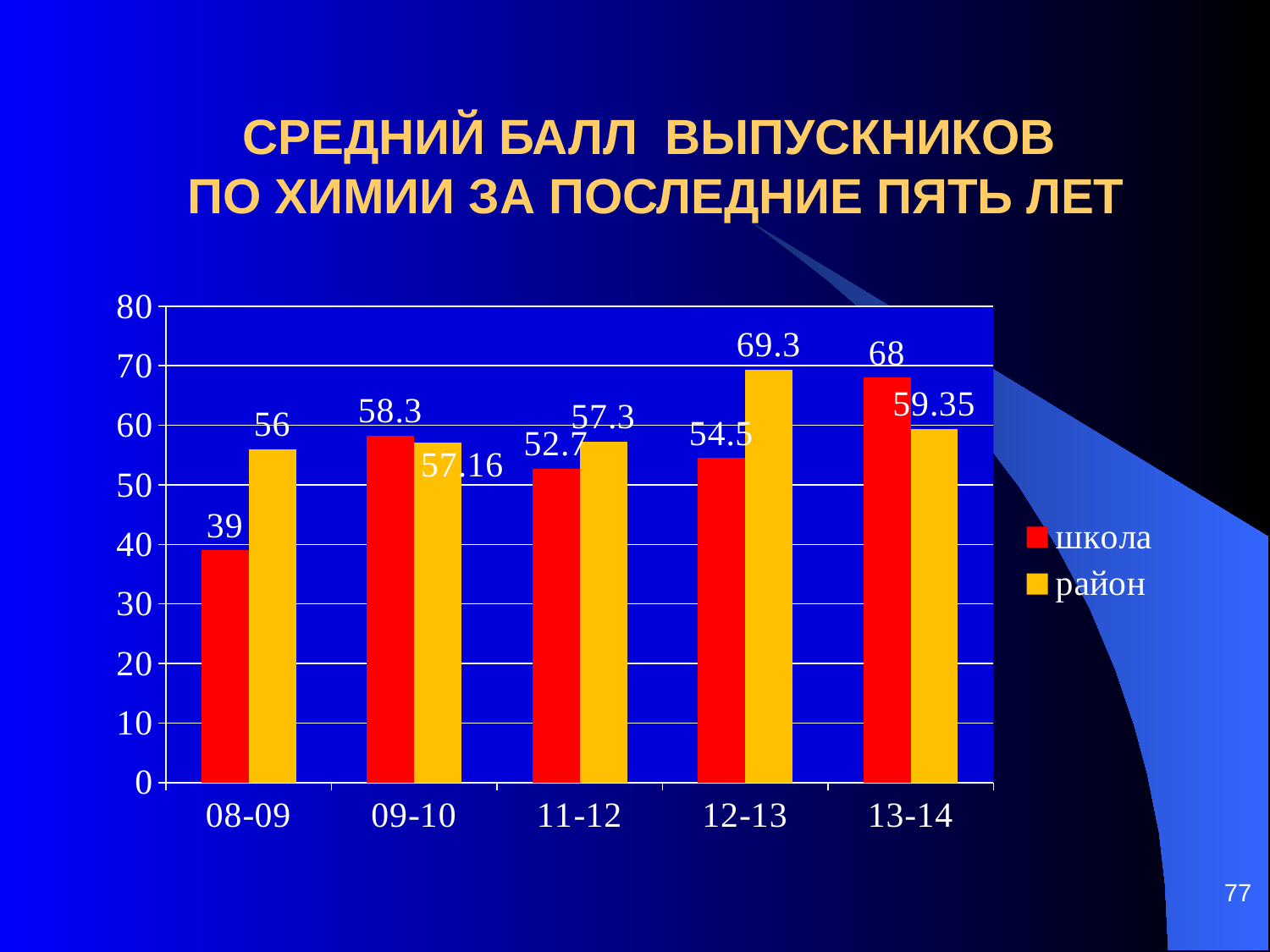
What kind of chart is shown on the slide? bar chart What is the value for район in 09-10? 57.16 In which year is the школа value lowest? 08-09 How many years are shown on the x axis? 5 What is the value for школа in 13-14? 68 How many series does the legend list? 2 What is the value for школа in 08-09? 39 What is the value for район in 12-13? 69.3 Which is larger in 13-14, школа or район? школа In which year is the район value highest? 12-13 In which year is the школа value highest? 13-14 What is the difference between район and школа in 08-09? 17